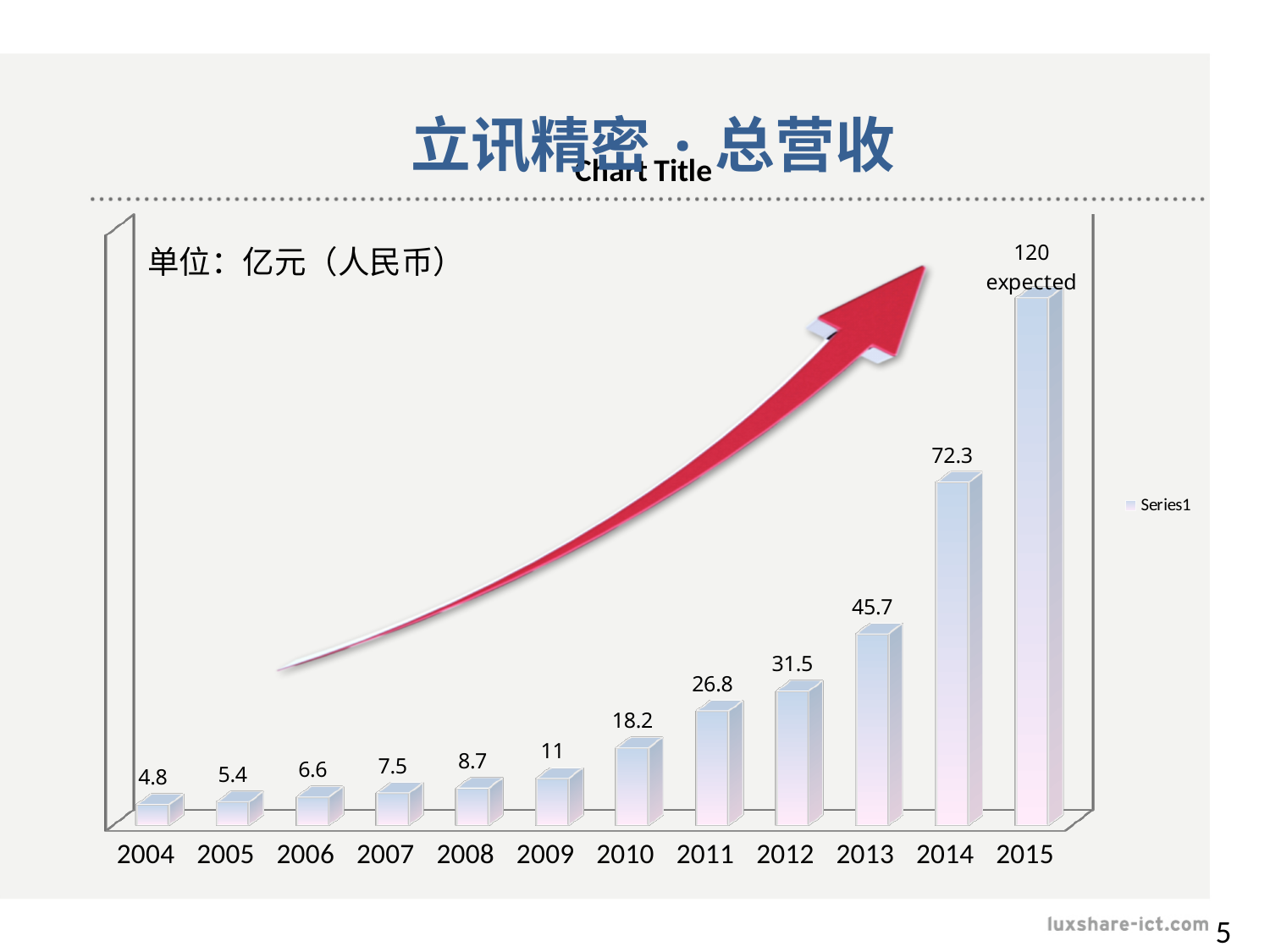
What is the value for 2010? 18.2 Which year has the lowest value? 2004 What is the value for 2014? 72.3 How many series does the legend list? 1 What kind of chart is shown? bar chart Which year has the highest value? 2015 What is the value for 2004? 4.8 What is the value labelled for 2015? 120 expected Which is larger, the value for 2011 or the value for 2012? 2012 Do the values rise or fall from 2004 to 2015? rise What is the difference between the values for 2014 and 2013? 26.6 How many years are shown on the x axis? 12